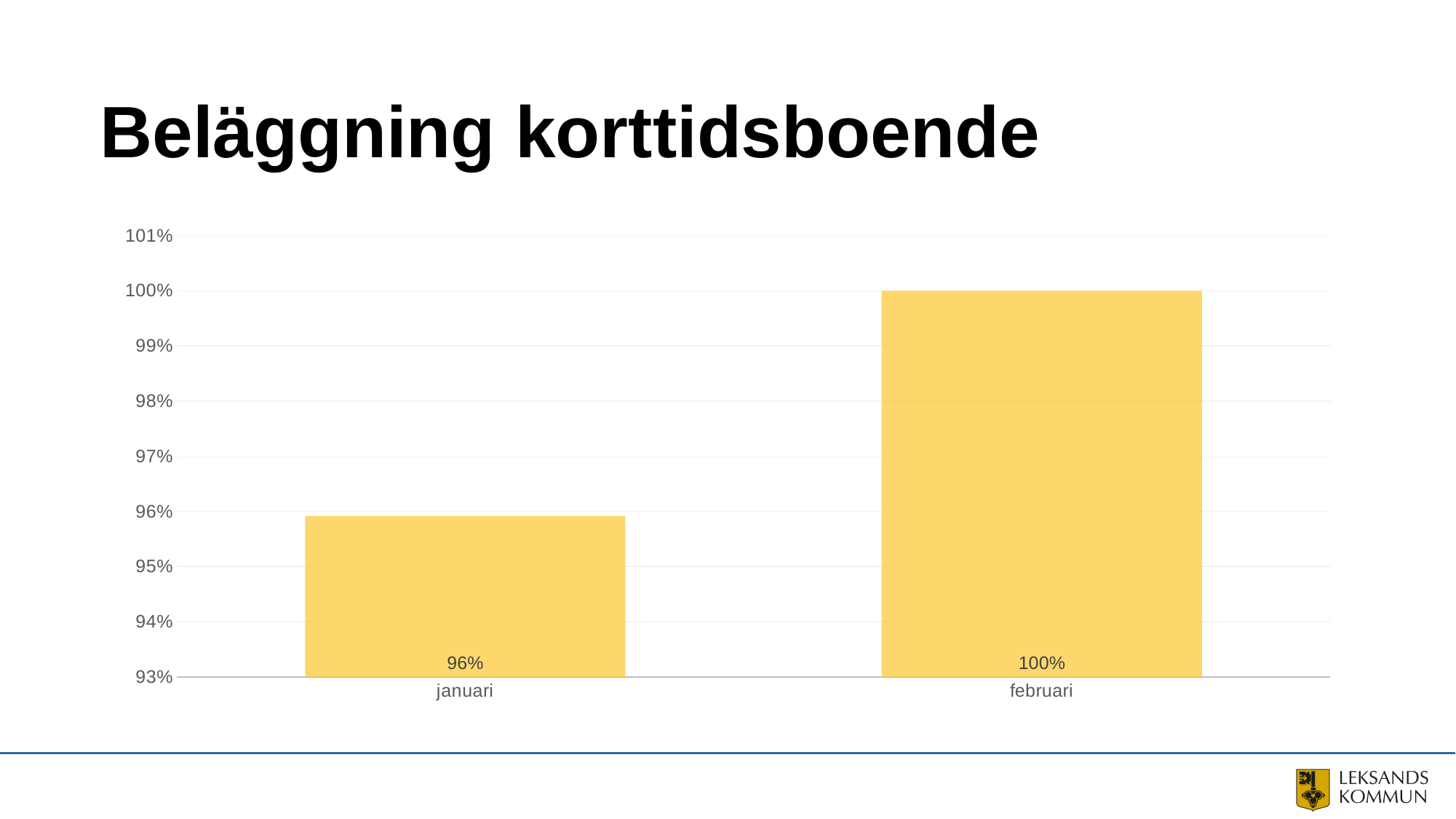
What is the value for januari? 96% Which month has the highest value? februari Which is larger, the value for januari or the value for februari? februari What is the value for februari? 100% Which month has the lowest value? januari What is the title of the slide? Beläggning korttidsboende What is the difference between the values for februari and januari? 4% What kind of chart is shown on the slide? bar chart Do the values rise or fall from januari to februari? rise How many categories are shown on the x axis? 2 Is the value for januari greater or less than 97%? less Is the value for februari greater or less than 98%? greater